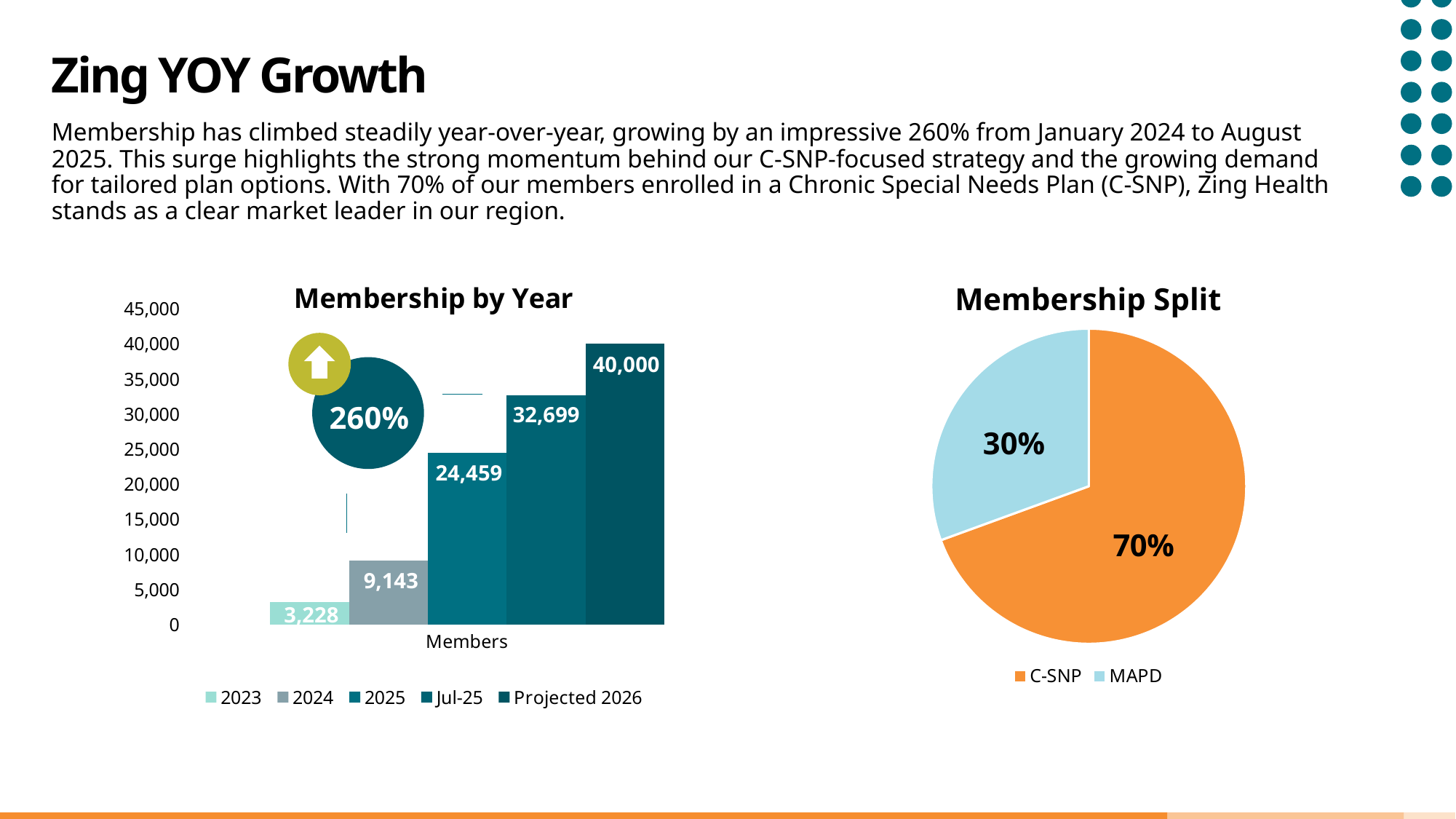
In the Membership by Year chart, what is the value for Jul-25? 32,699 In the Membership Split chart, what share of the pie is C-SNP? 70% What kind of chart is the Membership by Year chart? Bar chart In the Membership by Year chart, which series has the lowest value? 2023 How many series does the legend of the Membership by Year chart list? 5 In the Membership by Year chart, which is larger, the 2023 value or the 2024 value? 2024 What kind of chart is the Membership Split chart? Pie chart In the Membership by Year chart, what is the value for Projected 2026? 40,000 In the Membership by Year chart, what is the difference between the 2025 value and the 2024 value? 15,316 In the Membership Split chart, what share of the pie is MAPD? 30% In the Membership by Year chart, what is the value for the 2024 series? 9,143 In the Membership by Year chart, which series has the highest value? Projected 2026